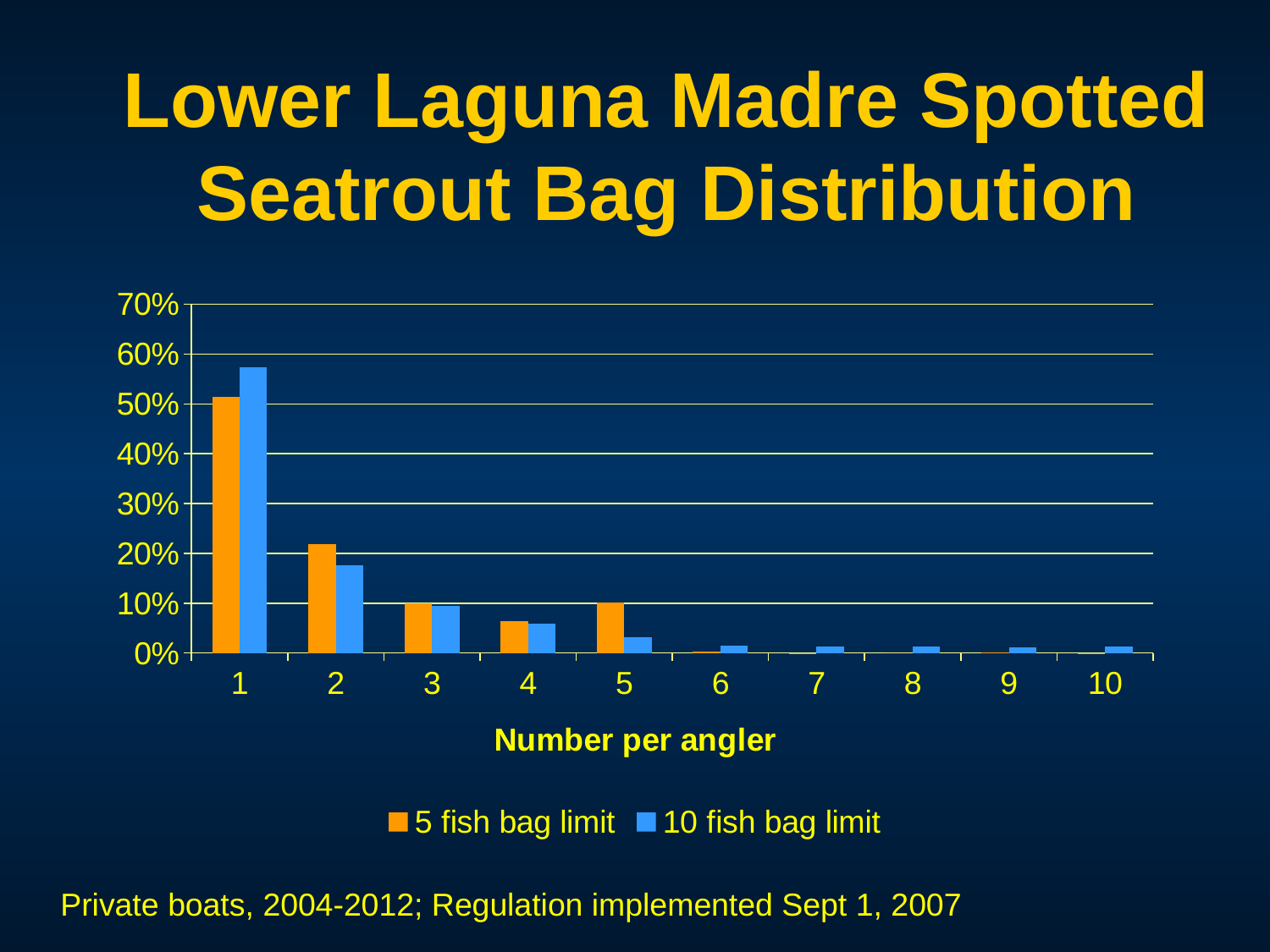
How many series does the legend list? 2 For the 10 fish bag limit series, which number per angler has the highest value? 1 Do the values for the 10 fish bag limit series rise or fall from 1 to 4 fish per angler? fall At 5 fish per angler, which series has the larger value, 5 fish bag limit or 10 fish bag limit? 5 fish bag limit For the 5 fish bag limit series, which number per angler has the highest value? 1 At 1 fish per angler, which series has the larger value, 5 fish bag limit or 10 fish bag limit? 10 fish bag limit How many categories are shown on the x axis (Number per angler)? 10 What kind of chart is shown on the slide? Bar chart Is the value for the 5 fish bag limit at 2 fish per angler greater or less than 30%? less Is the value for the 10 fish bag limit at 1 fish per angler greater or less than 50%? greater What is the title of the x axis? Number per angler At 2 fish per angler, which series has the larger value, 5 fish bag limit or 10 fish bag limit? 5 fish bag limit